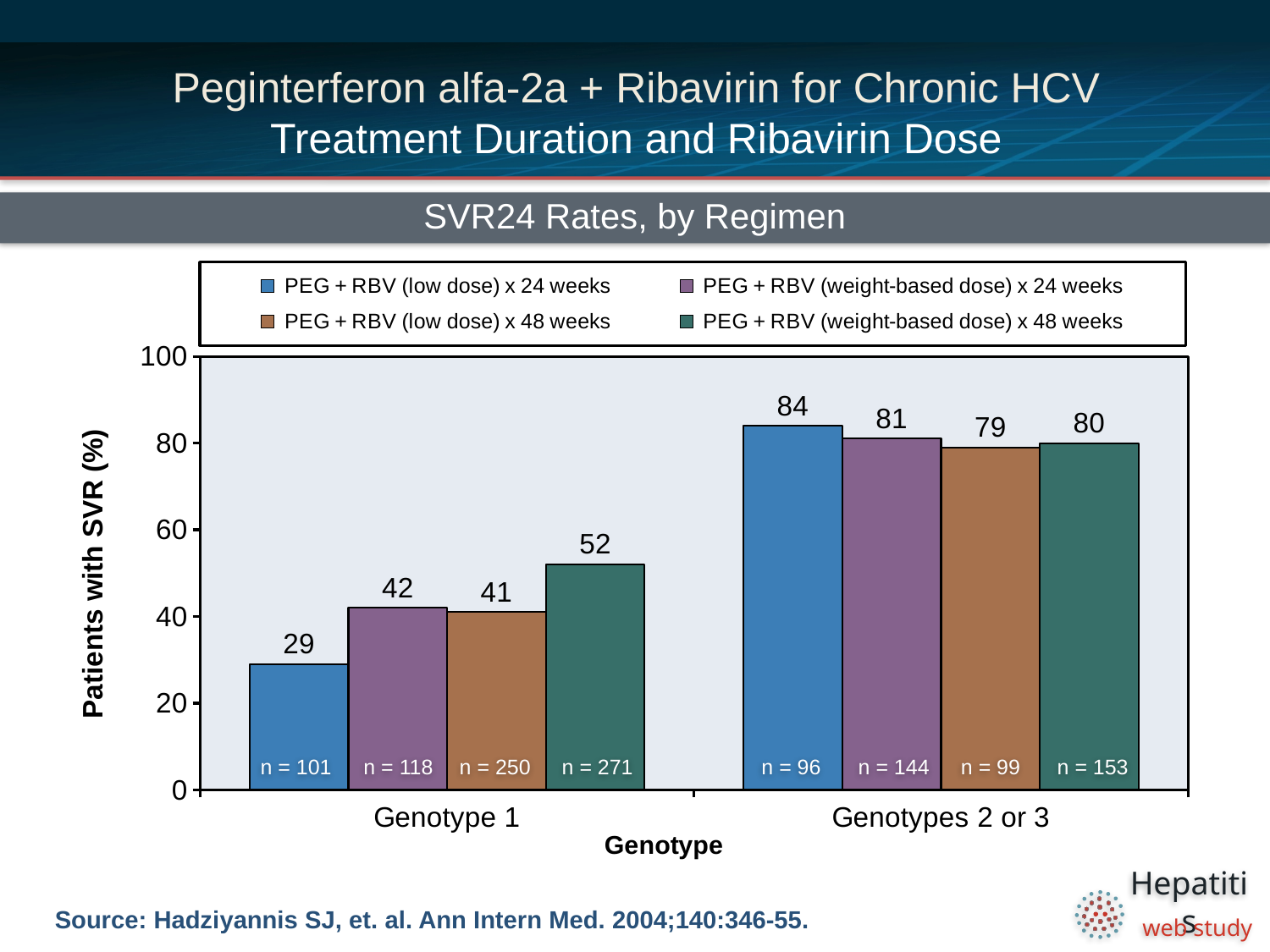
Which regimen has the highest SVR rate in Genotypes 2 or 3? PEG + RBV (low dose) x 24 weeks What is the SVR rate for PEG + RBV (weight-based dose) x 48 weeks in Genotypes 2 or 3? 80 What is the SVR rate for PEG + RBV (low dose) x 48 weeks in Genotype 1? 41 What is the label of the y axis? Patients with SVR (%) Which is larger in Genotype 1: the SVR rate for PEG + RBV (weight-based dose) x 24 weeks or PEG + RBV (low dose) x 48 weeks? PEG + RBV (weight-based dose) x 24 weeks Which regimen has the lowest SVR rate in Genotype 1? PEG + RBV (low dose) x 24 weeks What is the SVR rate for PEG + RBV (low dose) x 24 weeks in Genotype 1? 29 What is the difference in SVR rate between PEG + RBV (weight-based dose) x 48 weeks and PEG + RBV (low dose) x 24 weeks in Genotype 1? 23 What kind of chart is shown on the slide? Bar chart How many genotype categories are shown on the x axis? 2 How many series does the legend list? 4 What is the number of patients (n) for PEG + RBV (weight-based dose) x 48 weeks in Genotype 1? n = 271